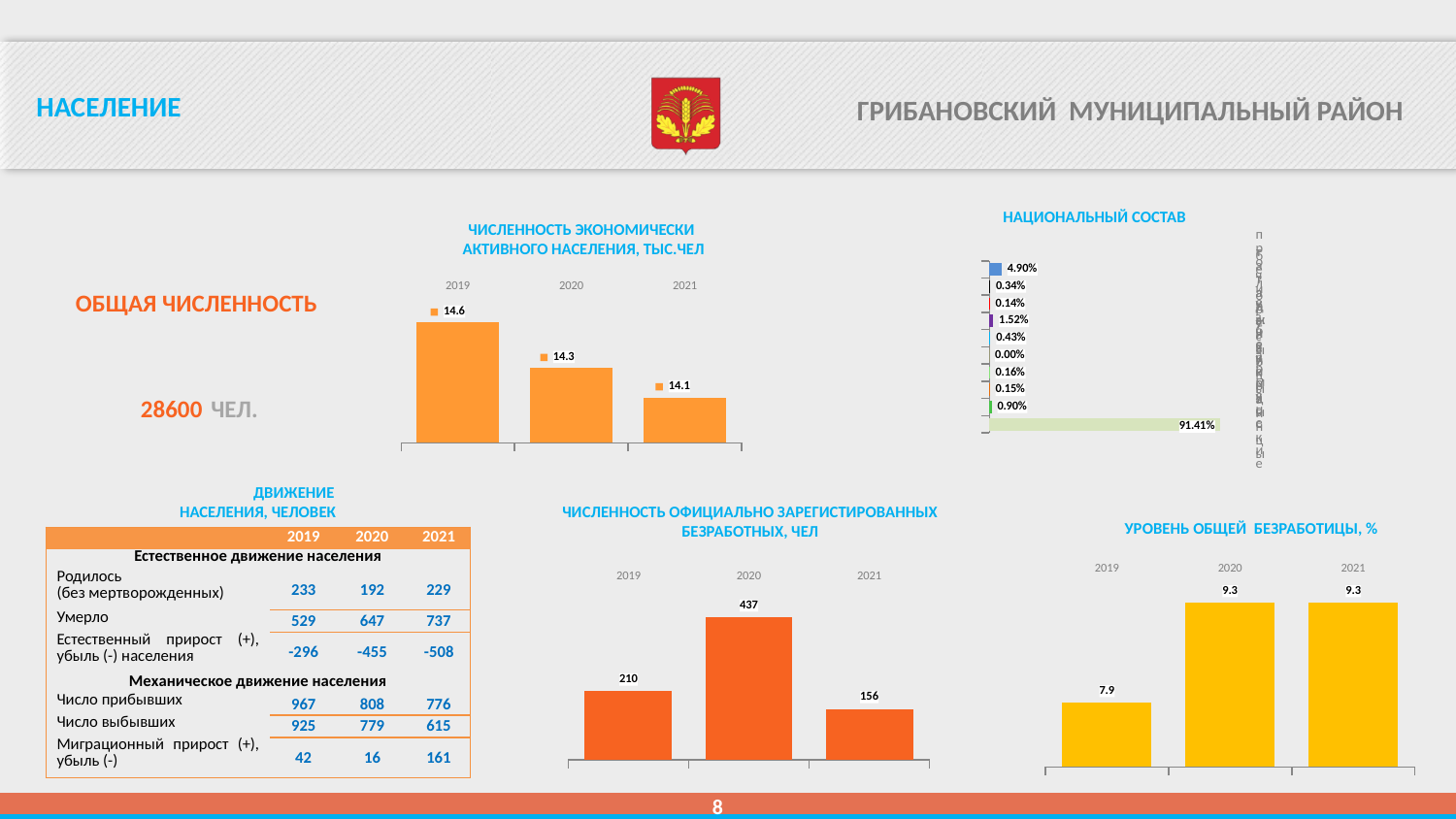
In the chart 'ЧИСЛЕННОСТЬ ЭКОНОМИЧЕСКИ АКТИВНОГО НАСЕЛЕНИЯ, ТЫС.ЧЕЛ', do the values rise or fall from 2019 to 2021? fall In the chart 'ЧИСЛЕННОСТЬ ЭКОНОМИЧЕСКИ АКТИВНОГО НАСЕЛЕНИЯ, ТЫС.ЧЕЛ', which year has the lowest value? 2021 In the chart 'ЧИСЛЕННОСТЬ ОФИЦИАЛЬНО ЗАРЕГИСТРИРОВАННЫХ БЕЗРАБОТНЫХ, ЧЕЛ', which year has the highest value? 2020 In the chart 'УРОВЕНЬ ОБЩЕЙ БЕЗРАБОТИЦЫ, %', what is the value for 2019? 7.9 In the chart 'ЧИСЛЕННОСТЬ ОФИЦИАЛЬНО ЗАРЕГИСТРИРОВАННЫХ БЕЗРАБОТНЫХ, ЧЕЛ', what is the difference between the values for 2020 and 2021? 281 In the chart 'ЧИСЛЕННОСТЬ ОФИЦИАЛЬНО ЗАРЕГИСТРИРОВАННЫХ БЕЗРАБОТНЫХ, ЧЕЛ', which is larger, the value for 2019 or 2021? 2019 What kind of chart is 'НАЦИОНАЛЬНЫЙ СОСТАВ'? bar chart In the chart 'ЧИСЛЕННОСТЬ ЭКОНОМИЧЕСКИ АКТИВНОГО НАСЕЛЕНИЯ, ТЫС.ЧЕЛ', what is the value for 2019? 14.6 In the chart 'УРОВЕНЬ ОБЩЕЙ БЕЗРАБОТИЦЫ, %', how many years are shown? 3 In the chart 'ЧИСЛЕННОСТЬ ОФИЦИАЛЬНО ЗАРЕГИСТРИРОВАННЫХ БЕЗРАБОТНЫХ, ЧЕЛ', what is the value for 2020? 437 In the chart 'НАЦИОНАЛЬНЫЙ СОСТАВ', how many bars are shown? 10 In the chart 'УРОВЕНЬ ОБЩЕЙ БЕЗРАБОТИЦЫ, %', what is the value for 2021? 9.3